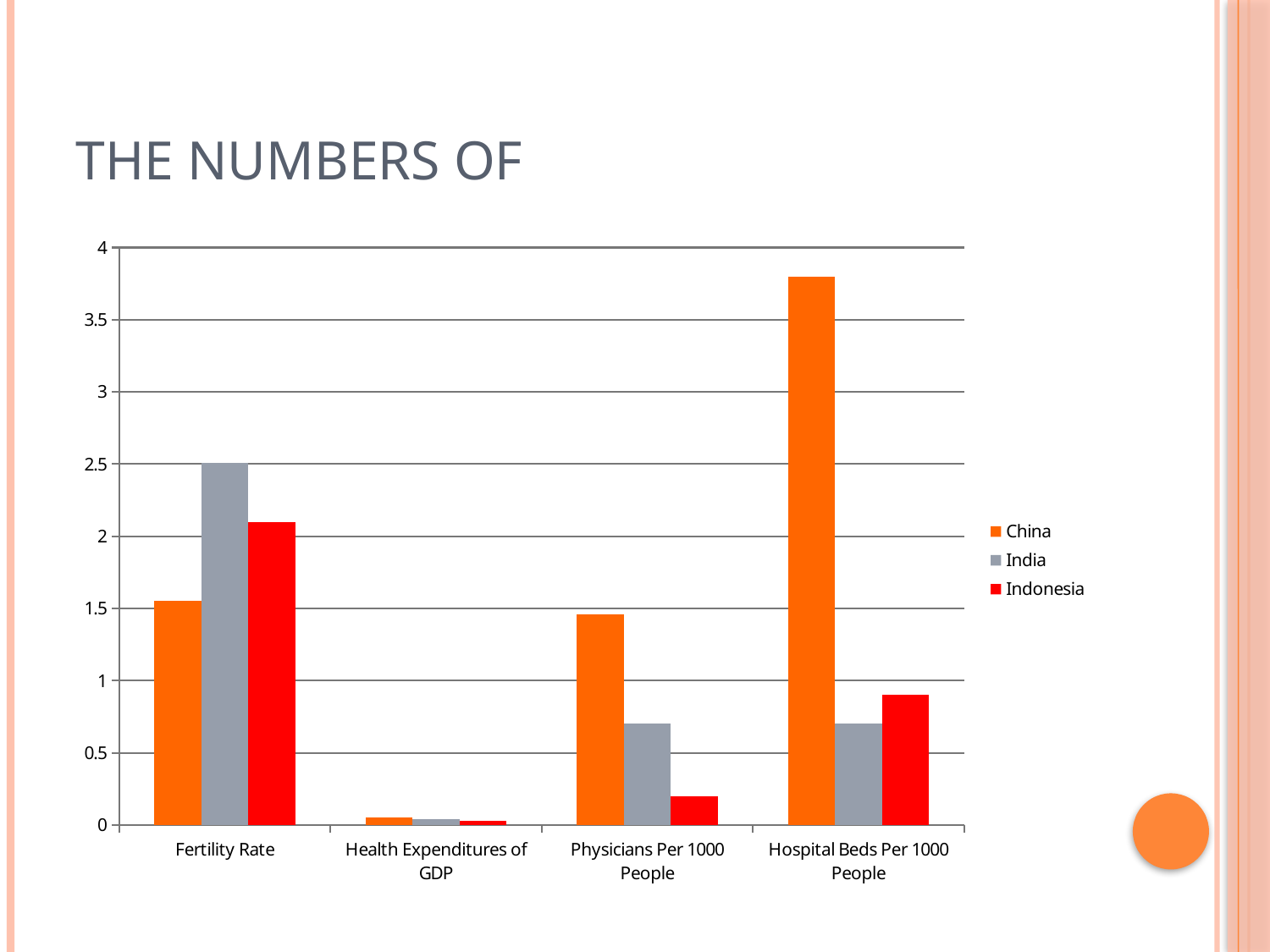
Is China's value for Physicians Per 1000 People greater or less than 1.5? less Which category has the lowest values for all three countries? Health Expenditures of GDP Which colour represents Indonesia in the legend? red Which country has the lowest value for Physicians Per 1000 People? Indonesia Which country has the highest Fertility Rate? India What kind of chart is shown on the slide? bar chart For Hospital Beds Per 1000 People, which is larger: India or Indonesia? Indonesia Is China's value for Hospital Beds Per 1000 People greater or less than 3.5? greater Which country has the highest value for Hospital Beds Per 1000 People? China How many series does the legend list? 3 How many categories are shown along the x axis? 4